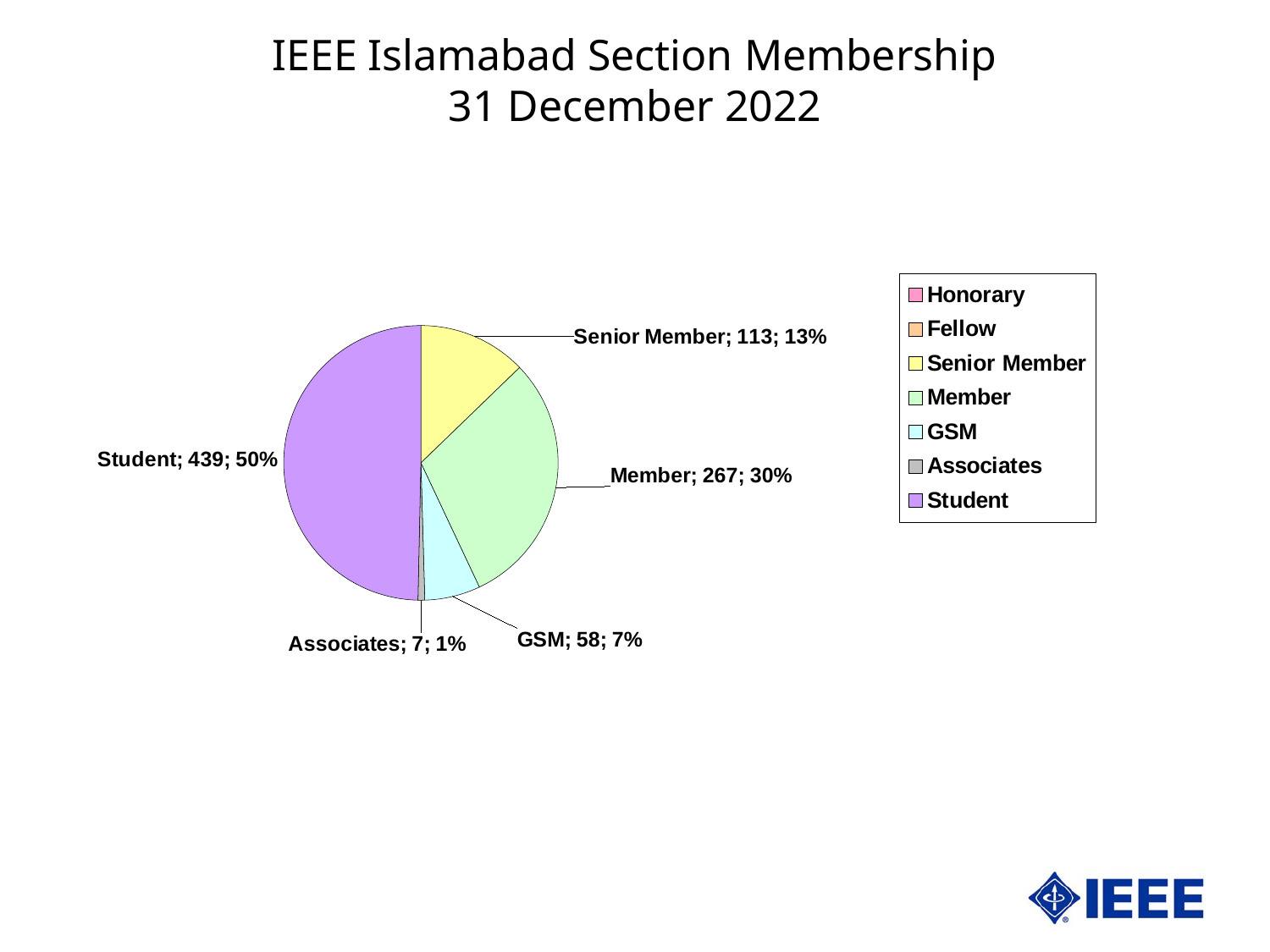
What kind of chart is shown on the slide? pie chart What percentage of the pie is the GSM slice? 7% How many categories does the legend list? 7 What is the difference between the Student count and the Member count? 172 Which is larger, the Senior Member count or the GSM count? Senior Member How many members does the Student slice represent? 439 Which labelled category has the smallest slice of the pie? Associates How many members does the Senior Member slice represent? 113 How many members does the Associates slice represent? 7 What percentage of the pie is the Member slice? 30% What is the title of the chart? IEEE Islamabad Section Membership 31 December 2022 Which category has the largest slice of the pie? Student